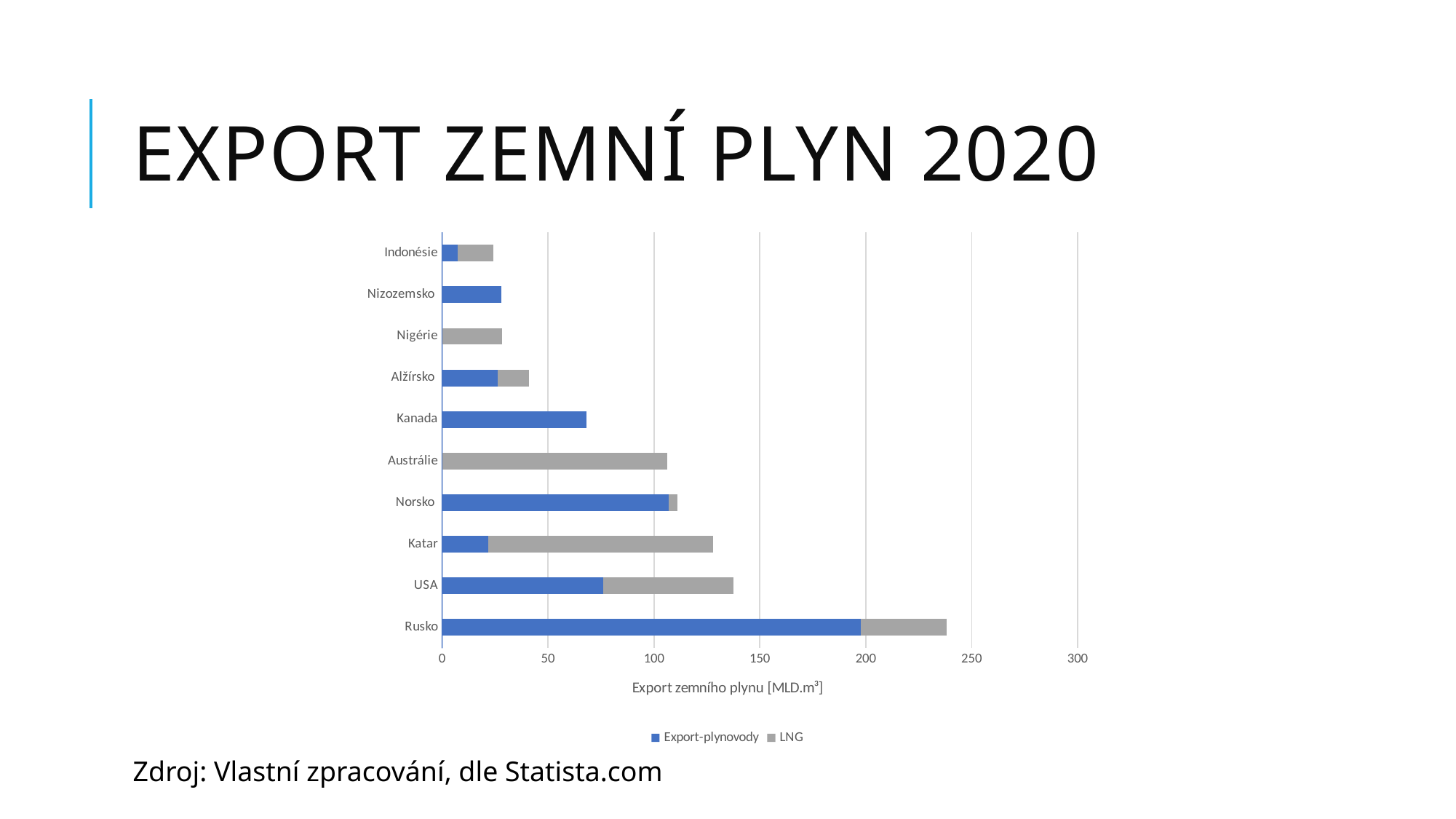
What kind of chart is shown on the slide? bar chart Is the total value for USA greater or less than 100? greater What are the two series listed in the legend? Export-plynovody and LNG Which country has the highest total natural gas export on the chart? Rusko How many countries are shown on the chart? 10 Is the total value for Katar greater or less than 150? less Is the value for Kanada greater or less than 50? greater How many series does the legend list? 2 Which has a larger total export, Kanada or Katar? Katar What is the title of the horizontal axis? Export zemního plynu [MLD.m³]